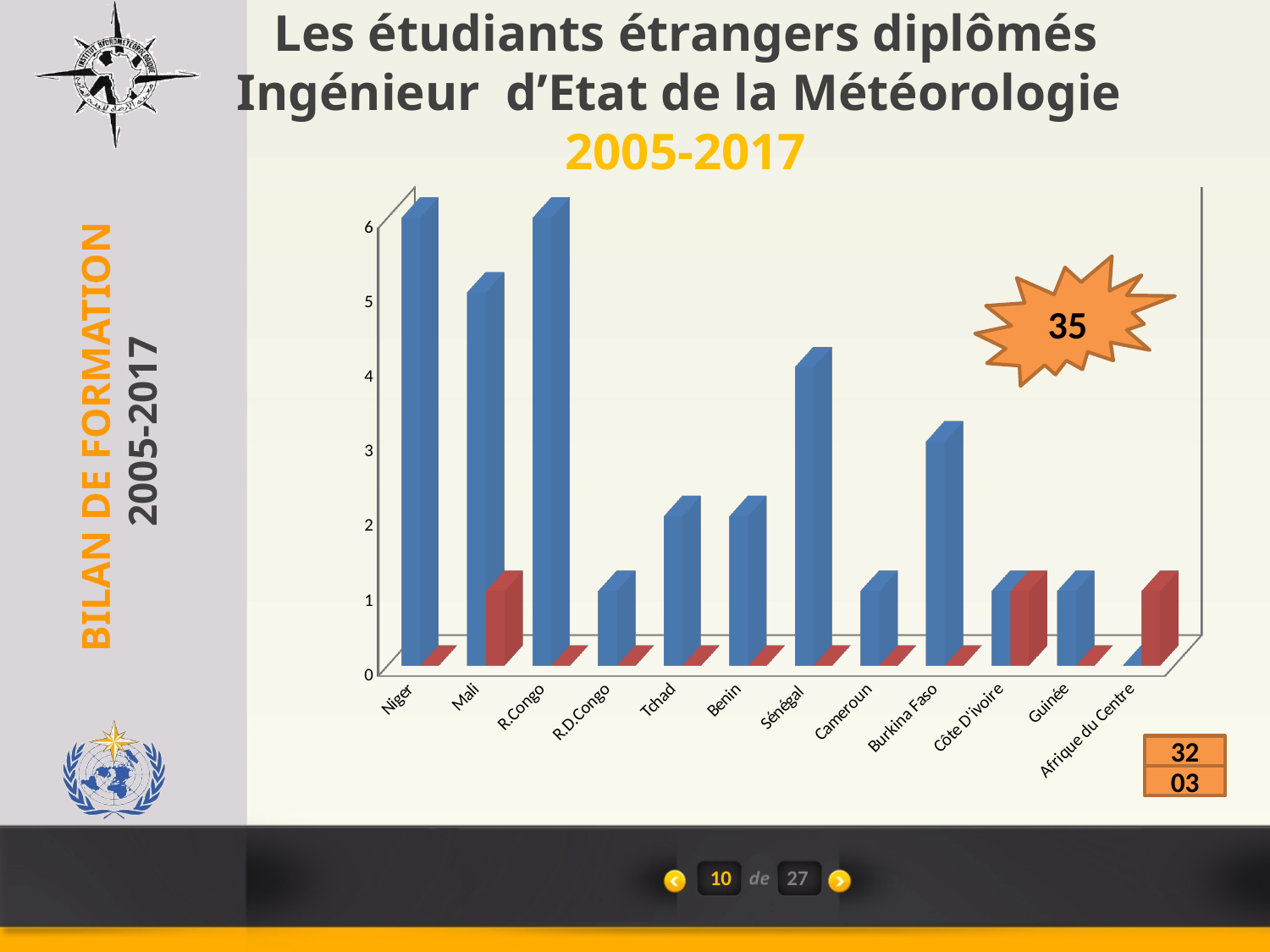
Is the blue bar value for Burkina Faso greater or less than 4? less Is the blue bar value for Niger greater or less than 5? greater Which category has no blue bar at all (the lowest blue value)? Afrique du Centre Which has the larger blue bar, Mali or Sénégal? Mali Is the blue bar value for Sénégal greater or less than 3? greater What number is shown in the orange starburst on the chart? 35 What period is given in the chart title? 2005-2017 What kind of chart is shown on the slide? bar chart How many countries/categories are shown along the x axis of the chart? 12 Which has the larger blue bar, Sénégal or Burkina Faso? Sénégal